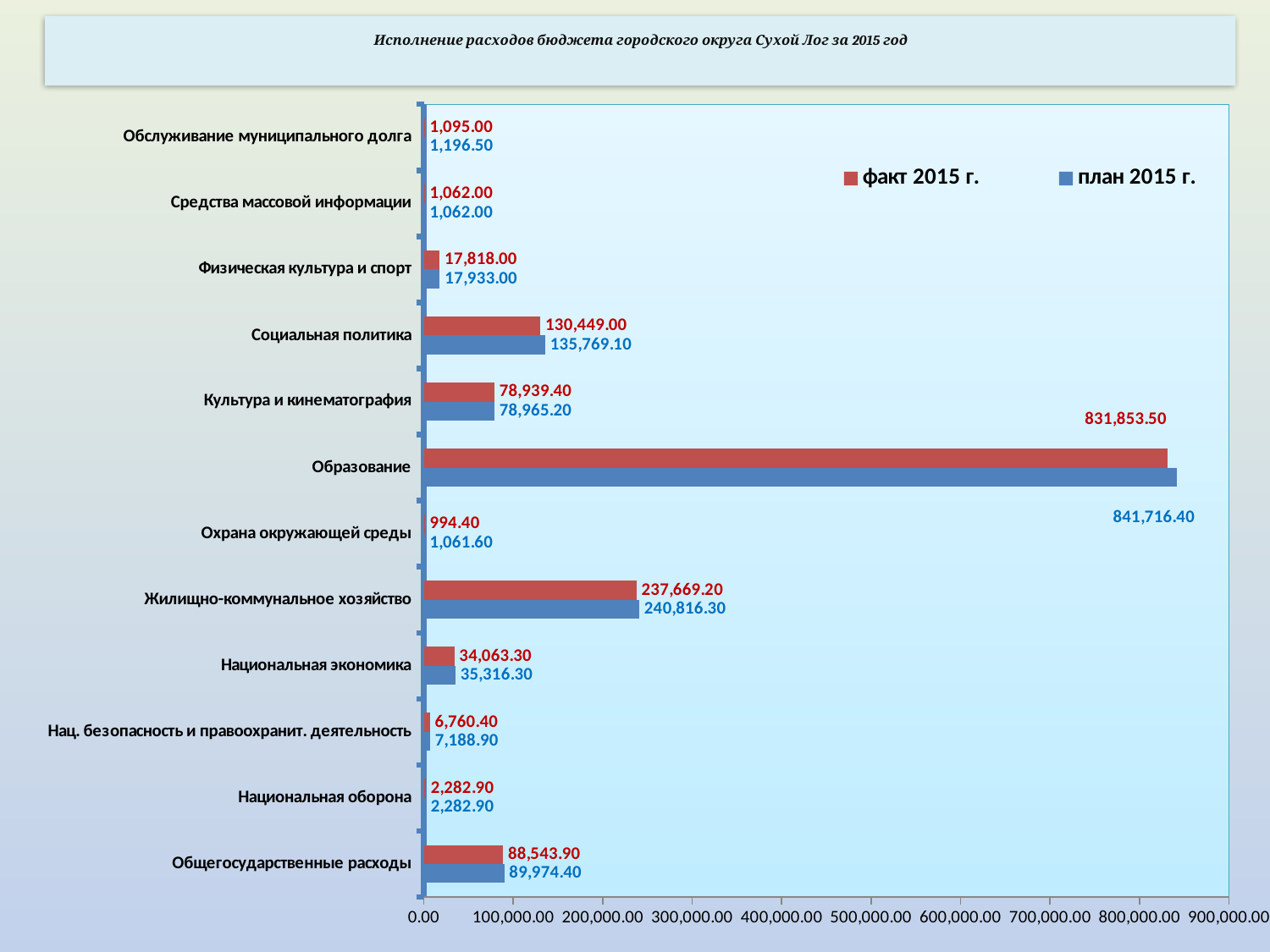
What is the difference between the план 2015 г. and факт 2015 г. values for Образование? 9,862.90 How many series does the legend list? 2 How many categories are shown on the chart? 12 Which is larger for Социальная политика: the факт 2015 г. value or the план 2015 г. value? план 2015 г. Which category has the lowest факт 2015 г. value? Охрана окружающей среды Which category has the highest план 2015 г. value? Образование What type of chart is shown on the slide? bar chart What is the факт 2015 г. value for Национальная экономика? 34,063.30 What is the план 2015 г. value for Охрана окружающей среды? 1,061.60 Which series is shown in red? факт 2015 г. What is the план 2015 г. value for Жилищно-коммунальное хозяйство? 240,816.30 What is the факт 2015 г. value for Образование? 831,853.50